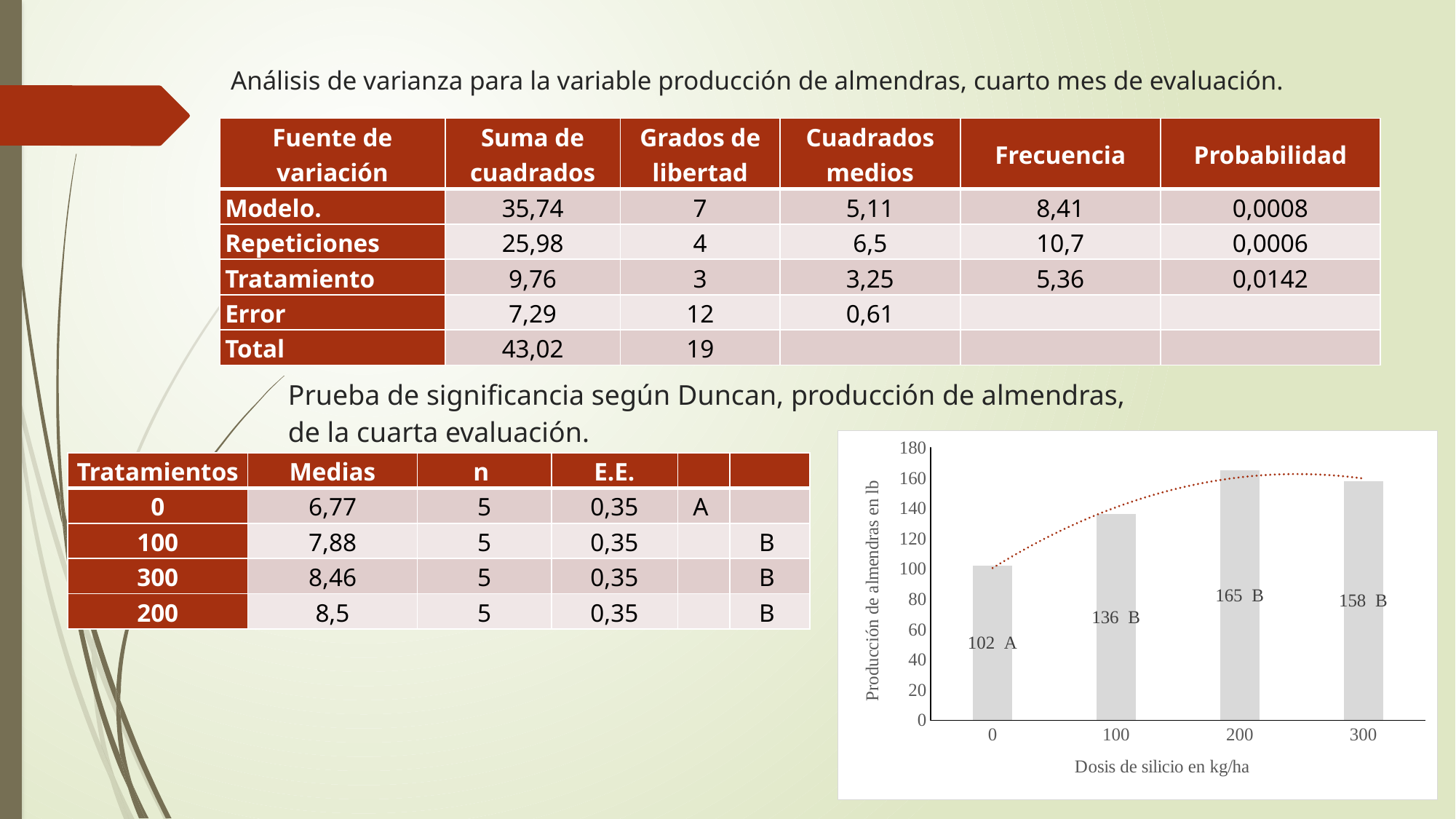
What kind of chart is shown on the slide? bar chart In the bar chart, what is the almond production value for the 300 kg/ha silicon dose? 158 In the bar chart, which silicon dose has the highest almond production? 200 In the bar chart, what is the almond production value for the 0 kg/ha silicon dose? 102 In the bar chart, what is the difference in almond production between the 200 and 300 kg/ha doses? 7 In the bar chart, which silicon dose has the lowest almond production? 0 In the bar chart, do the values rise or fall from the 0 dose to the 200 dose? rise In the bar chart, which dose has higher almond production, 100 or 300 kg/ha? 300 How many silicon dose categories are shown in the bar chart? 4 In the bar chart, what is the difference in almond production between the 100 and 0 kg/ha doses? 34 In the bar chart, what is the almond production value for the 200 kg/ha silicon dose? 165 In the bar chart, is the value for the 100 kg/ha dose greater or less than 140? less